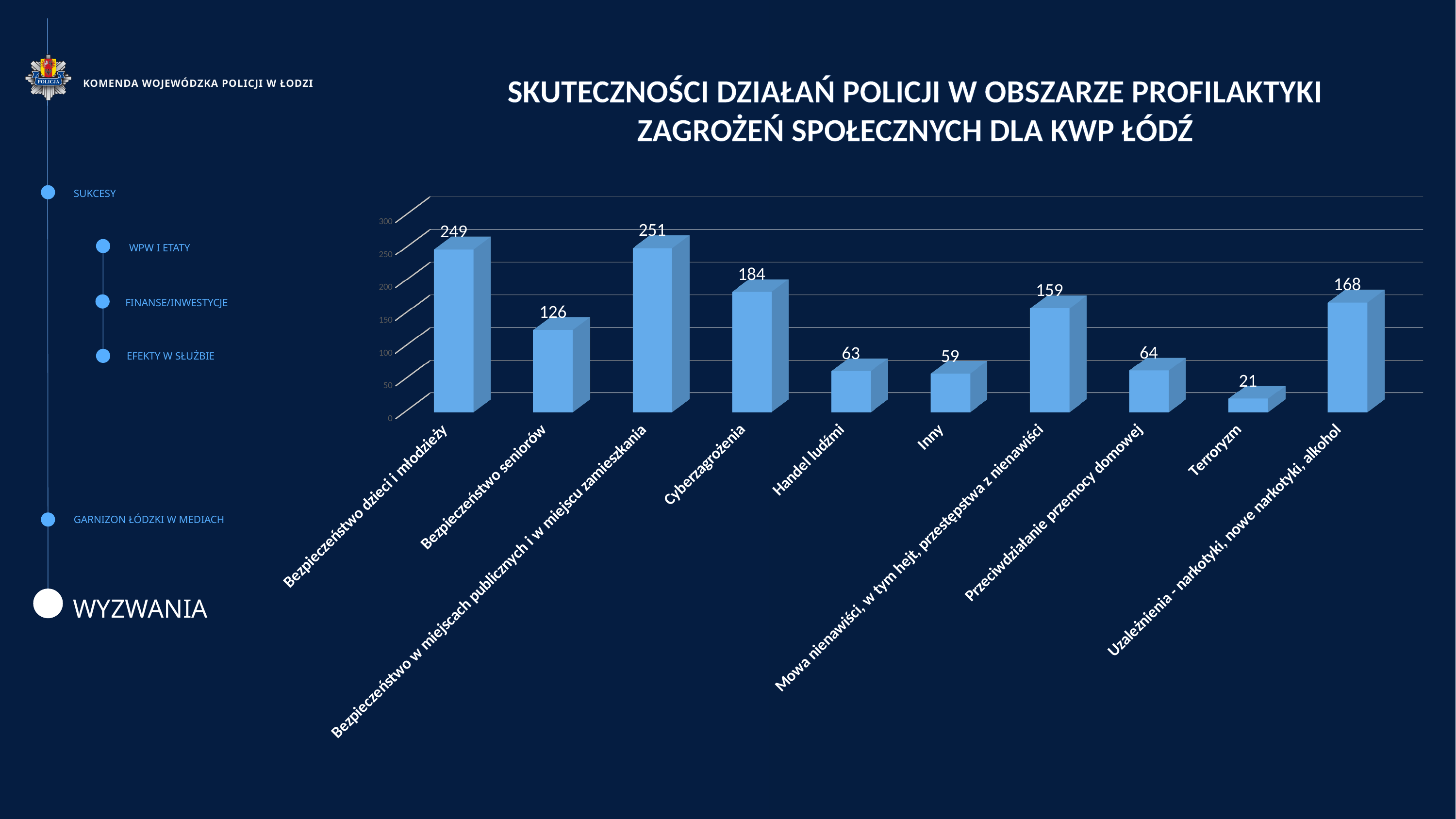
What is the value for Bezpieczeństwo seniorów? 126 What is the value for Inny? 59 Which category has the lowest value? Terroryzm How many categories are shown in the chart? 10 Which is larger, the value for Handel ludźmi or the value for Przeciwdziałanie przemocy domowej? Przeciwdziałanie przemocy domowej What kind of chart is shown on the slide? bar chart What is the value for Uzależnienia - narkotyki, nowe narkotyki, alkohol? 168 Which category has the highest value? Bezpieczeństwo w miejscach publicznych i w miejscu zamieszkania Is the value for Mowa nienawiści, w tym hejt, przestępstwa z nienawiści greater or less than 150? greater What is the difference between the values for Bezpieczeństwo dzieci i młodzieży and Bezpieczeństwo seniorów? 123 What is the value for Terroryzm? 21 What is the value for Cyberzagrożenia? 184